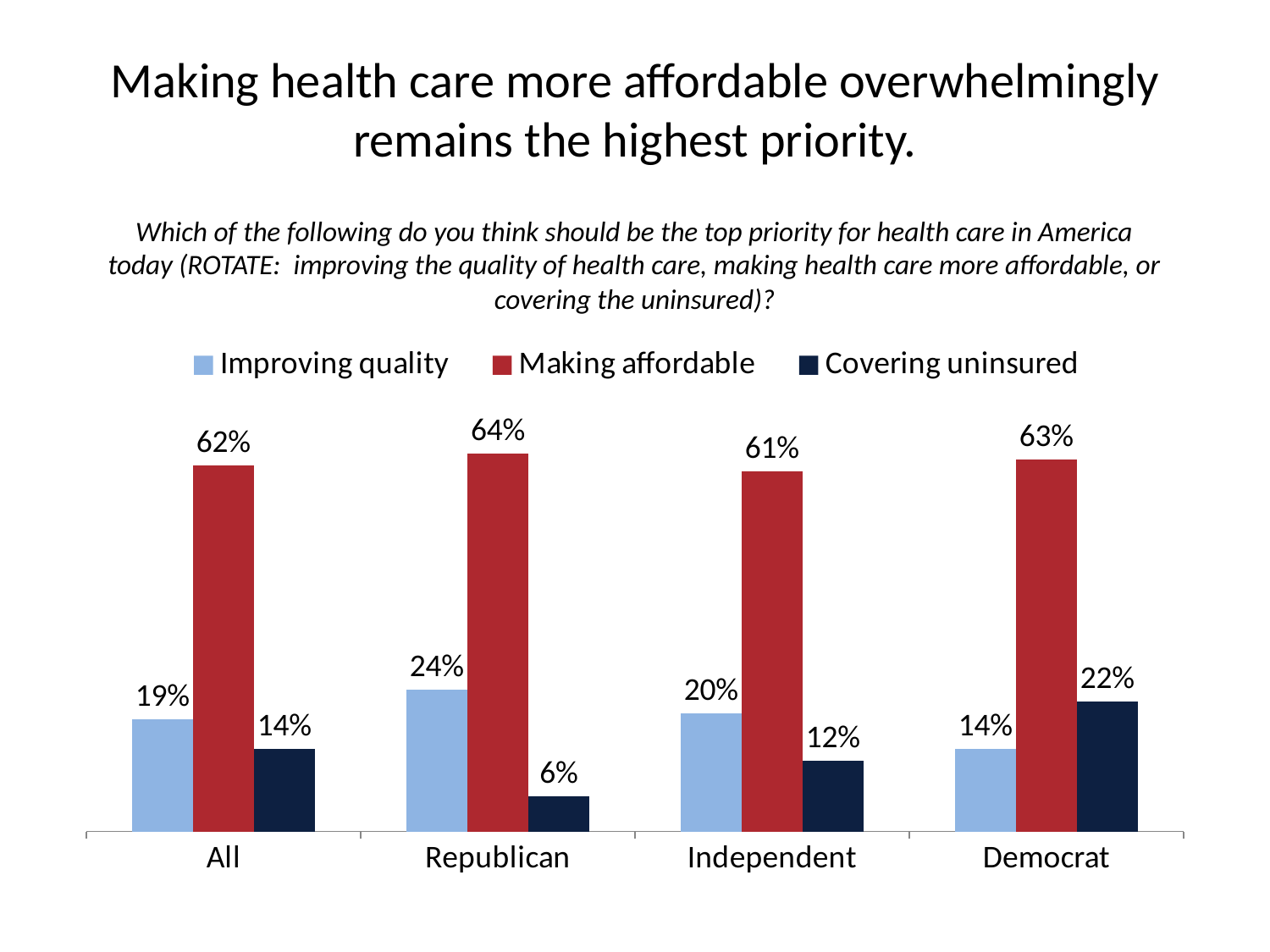
How many series does the legend list? 3 What is the value for "Covering uninsured" among Democrats? 22% What percentage of Republicans chose "Making affordable" as the top priority? 64% Which is larger for Democrats: "Improving quality" or "Covering uninsured"? Covering uninsured What kind of chart is shown on the slide? Bar chart Which group has the lowest value for "Covering uninsured"? Republican What colour are the "Making affordable" bars? Red How many groups are shown on the x axis? 4 What is the value for "Improving quality" in the All group? 19% What is the difference between "Making affordable" and "Improving quality" for Independents? 41 percentage points What is the difference between the "Covering uninsured" values for Democrats and Republicans? 16 percentage points Which group has the highest value for "Improving quality"? Republican